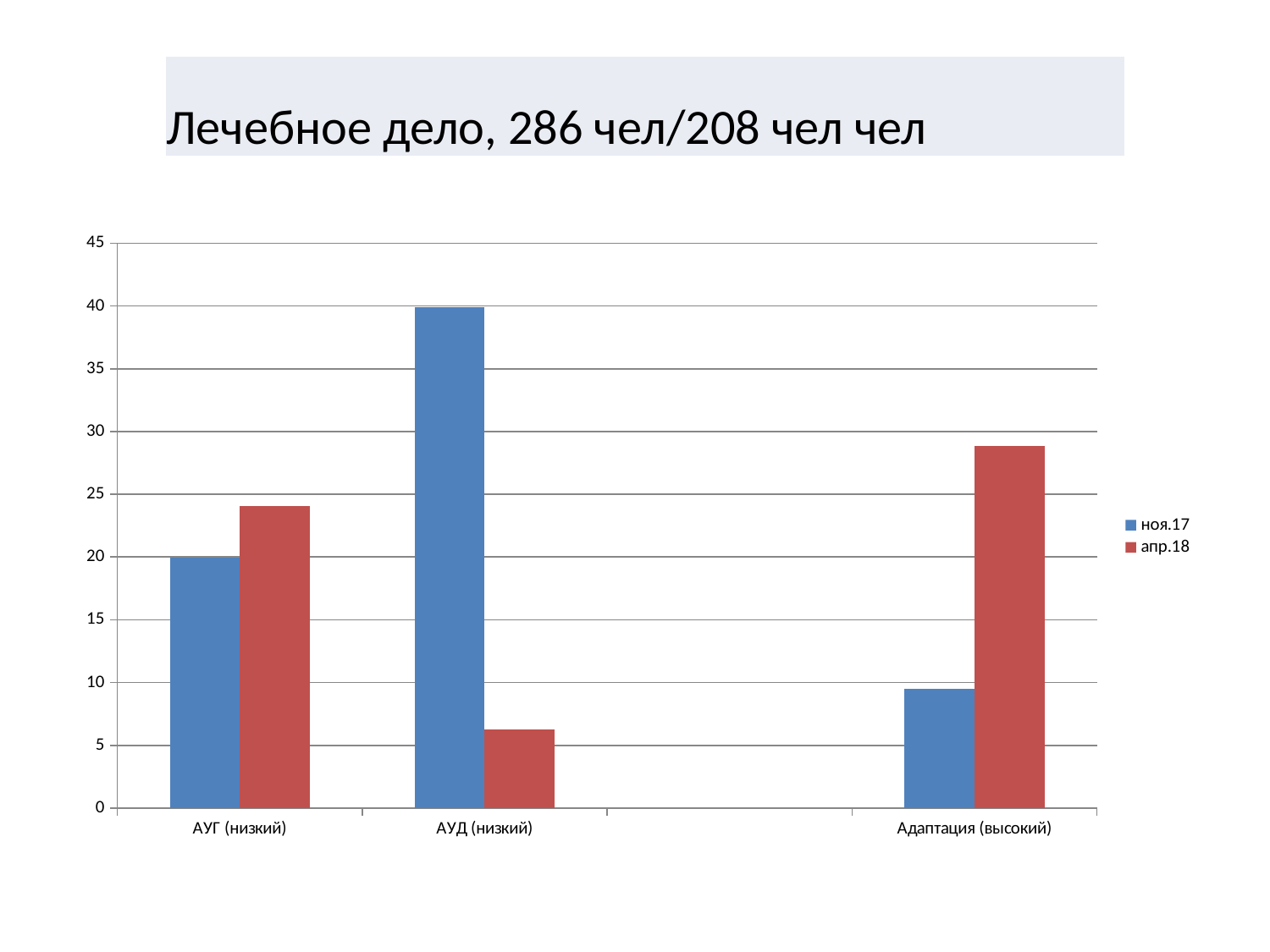
For the апр.18 series, which category has the lowest bar? АУД (низкий) For the апр.18 series, which category has the highest bar? Адаптация (высокий) Is the апр.18 value for АУД (низкий) greater or less than 10? less What is the title of the slide above the chart? Лечебное дело, 286 чел/208 чел чел For АУГ (низкий), which series has the larger value, ноя.17 or апр.18? апр.18 For the ноя.17 series, which category has the lowest bar? Адаптация (высокий) Is the апр.18 value for Адаптация (высокий) greater or less than 25? greater What are the two series named in the legend? ноя.17 and апр.18 How many series does the legend list? 2 For the ноя.17 series, which category has the highest bar? АУД (низкий) Is the ноя.17 value for АУД (низкий) greater or less than 35? greater What kind of chart is shown on the slide? bar chart